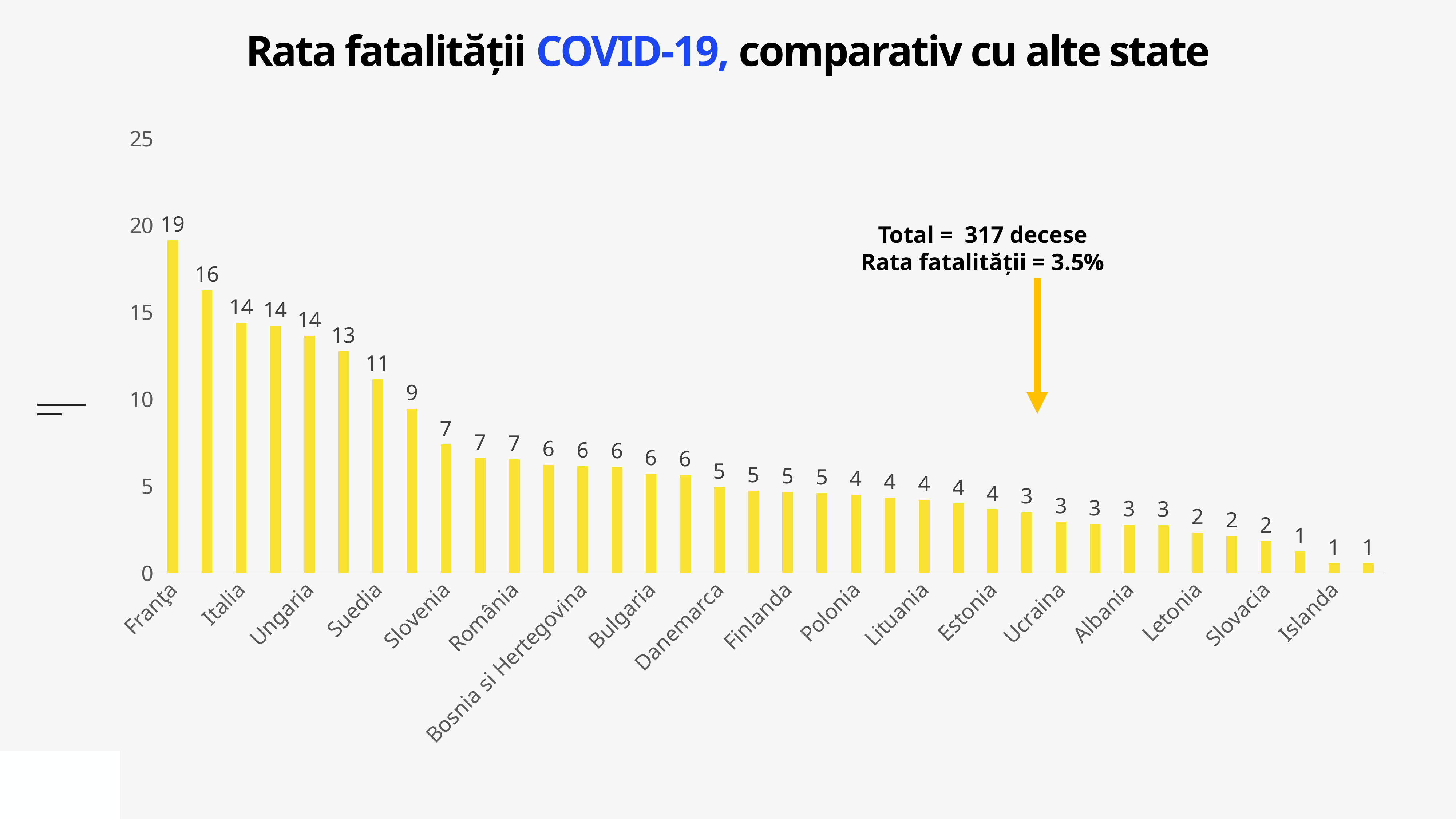
What is the value shown for Suedia? 11 Which is larger, the value for Suedia or the value for Slovenia? Suedia What is the value shown for Franța? 19 How many bars are plotted in the chart? 36 What is the difference between the values for Franța and Italia? 5 According to the annotation on the slide, what is the total number of deaths (decese)? 317 What is the value shown for Italia? 14 Do the values rise or fall from left to right along the x axis? fall What is the value shown for Islanda? 1 What is the value shown for Ucraina? 3 What kind of chart is shown on the slide? bar chart Which country has the highest fatality rate in the chart? Franța